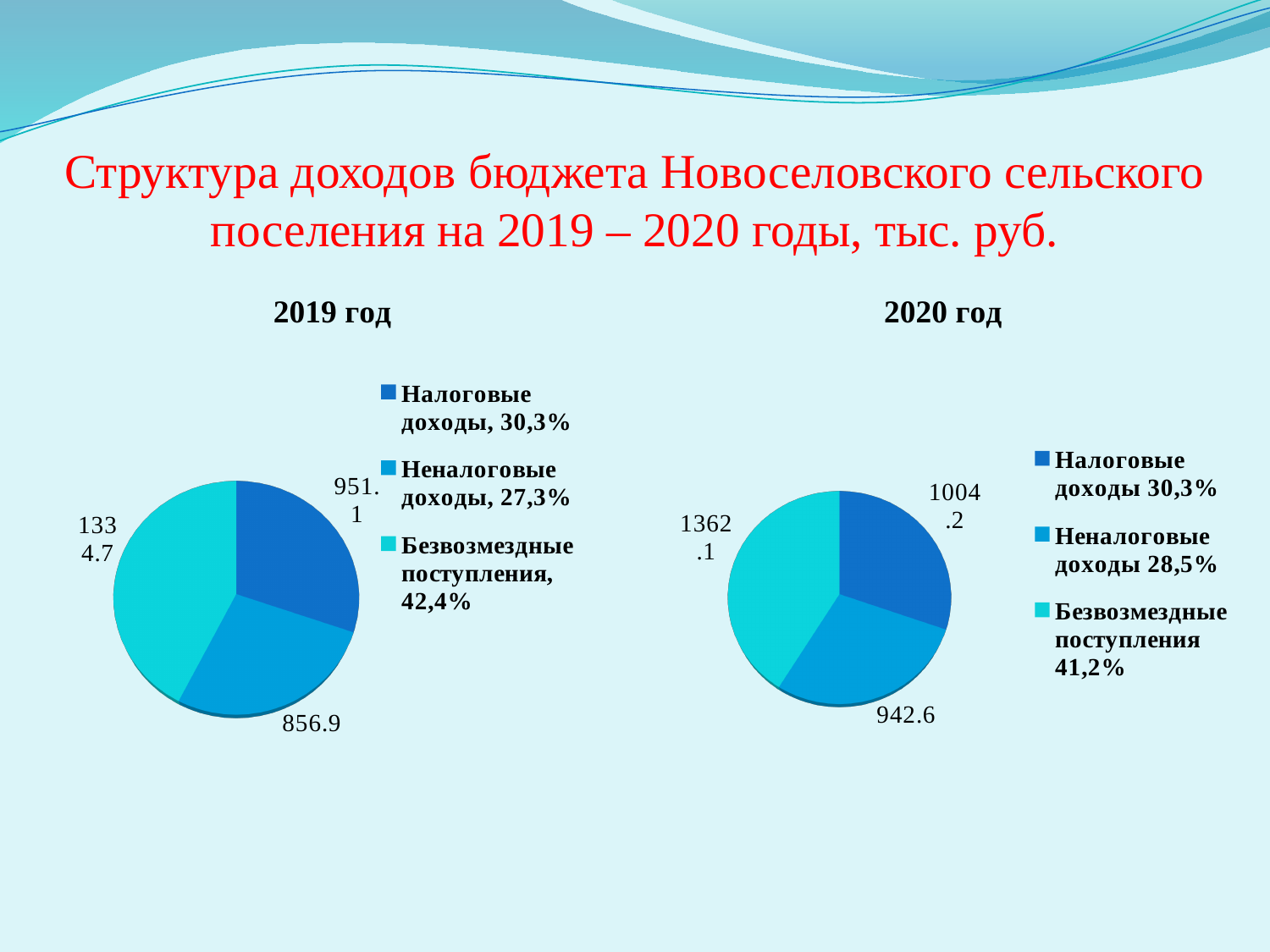
In the 2019 год chart, what is the value for Налоговые доходы? 951.1 In the 2020 год chart, what is the value for Неналоговые доходы? 942.6 How many slices does the 2020 год chart have? 3 In the 2019 год chart, what share of the pie does Безвозмездные поступления represent according to the legend? 42,4% In the 2020 год chart, what is the value for Безвозмездные поступления? 1362.1 In the 2019 год chart, which category has the largest slice? Безвозмездные поступления In the 2019 год chart, what is the difference between Налоговые доходы and Неналоговые доходы? 94.2 In the 2020 год chart, which category has the smallest slice? Неналоговые доходы In the 2020 год chart, which is larger: Налоговые доходы or Безвозмездные поступления? Безвозмездные поступления In the 2020 год chart, what share of the pie does Неналоговые доходы represent according to the legend? 28,5% What type of chart is the 2019 год chart? Pie chart In the 2019 год chart, what is the value for Безвозмездные поступления? 1334.7